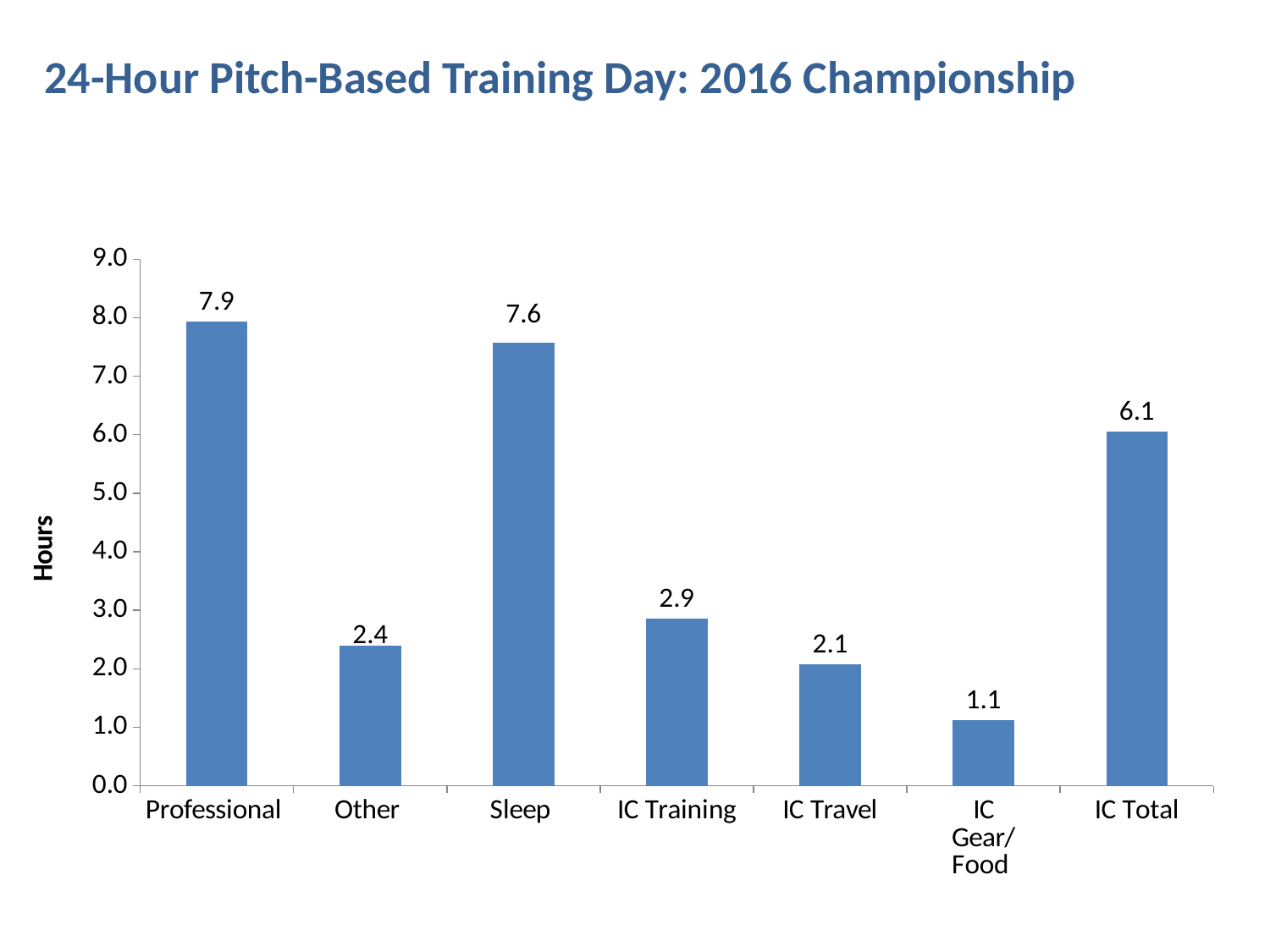
How many categories are shown on the x axis? 7 How many hours are shown for IC Gear/Food? 1.1 Which category has the highest value? Professional What is the value for Sleep? 7.6 What is the label of the vertical axis? Hours How many hours are shown for Professional? 7.9 What kind of chart is this? bar chart Is the value for IC Total greater or less than 5.0? greater What is the difference between IC Training and IC Travel? 0.8 Which category has the lowest value? IC Gear/Food What is the value for IC Total? 6.1 Which is larger, Other or IC Training? IC Training